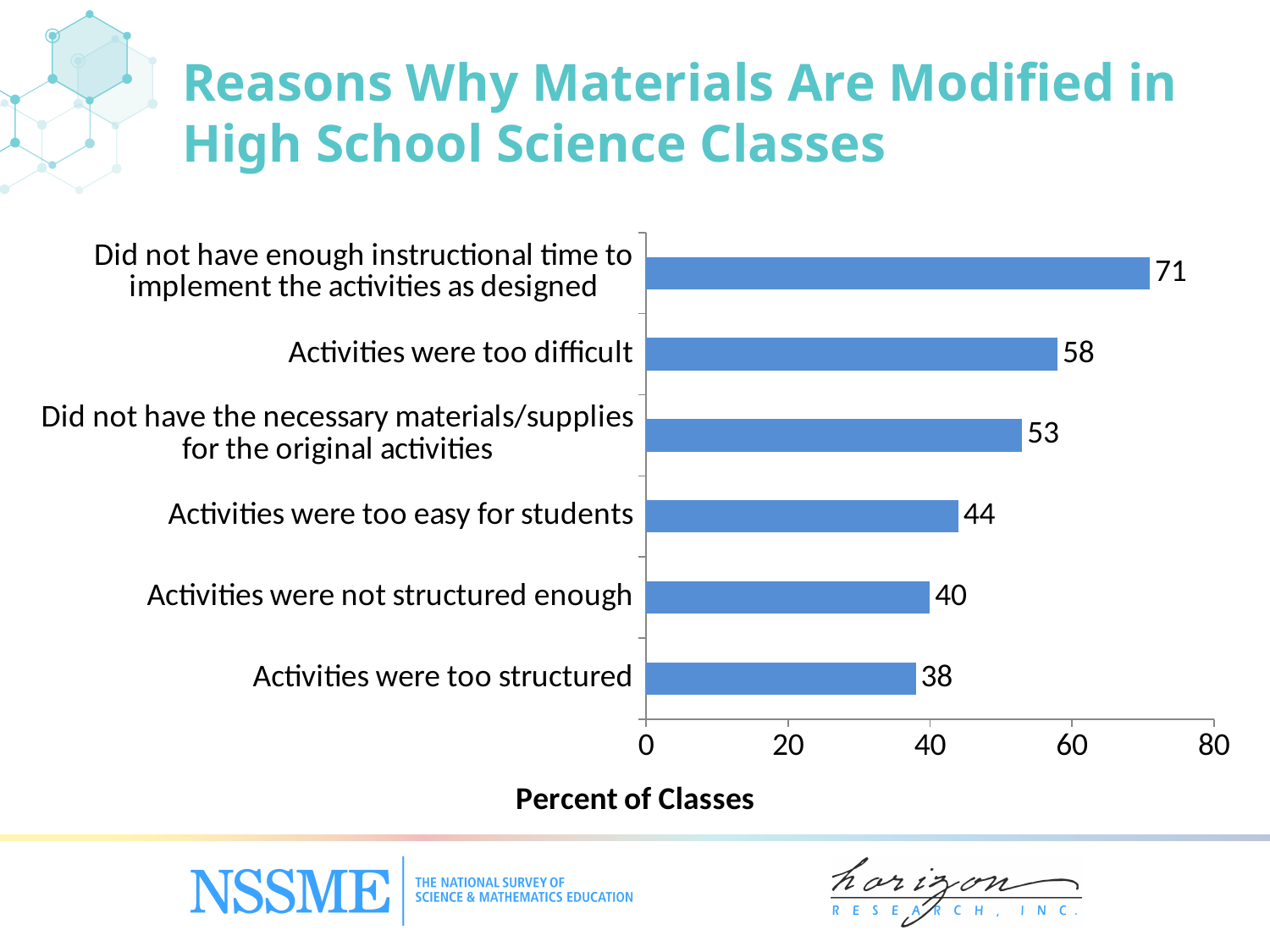
Which reason has the highest percent of classes? Did not have enough instructional time to implement the activities as designed What is the value for 'Activities were too structured'? 38 Which reason has the lowest percent of classes? Activities were too structured How many reasons are shown on the chart? 6 What is the value for 'Activities were too difficult'? 58 Which is larger: 'Activities were too difficult' or 'Did not have the necessary materials/supplies for the original activities'? Activities were too difficult What is the difference between the highest and lowest values on the chart? 33 What percent of classes cited 'Did not have the necessary materials/supplies for the original activities'? 53 What kind of chart is shown on the slide? Bar chart What is the label of the horizontal axis? Percent of Classes What is the difference between 'Activities were too easy for students' and 'Activities were not structured enough'? 4 What percent of classes reported 'Did not have enough instructional time to implement the activities as designed' as a reason for modifying materials? 71